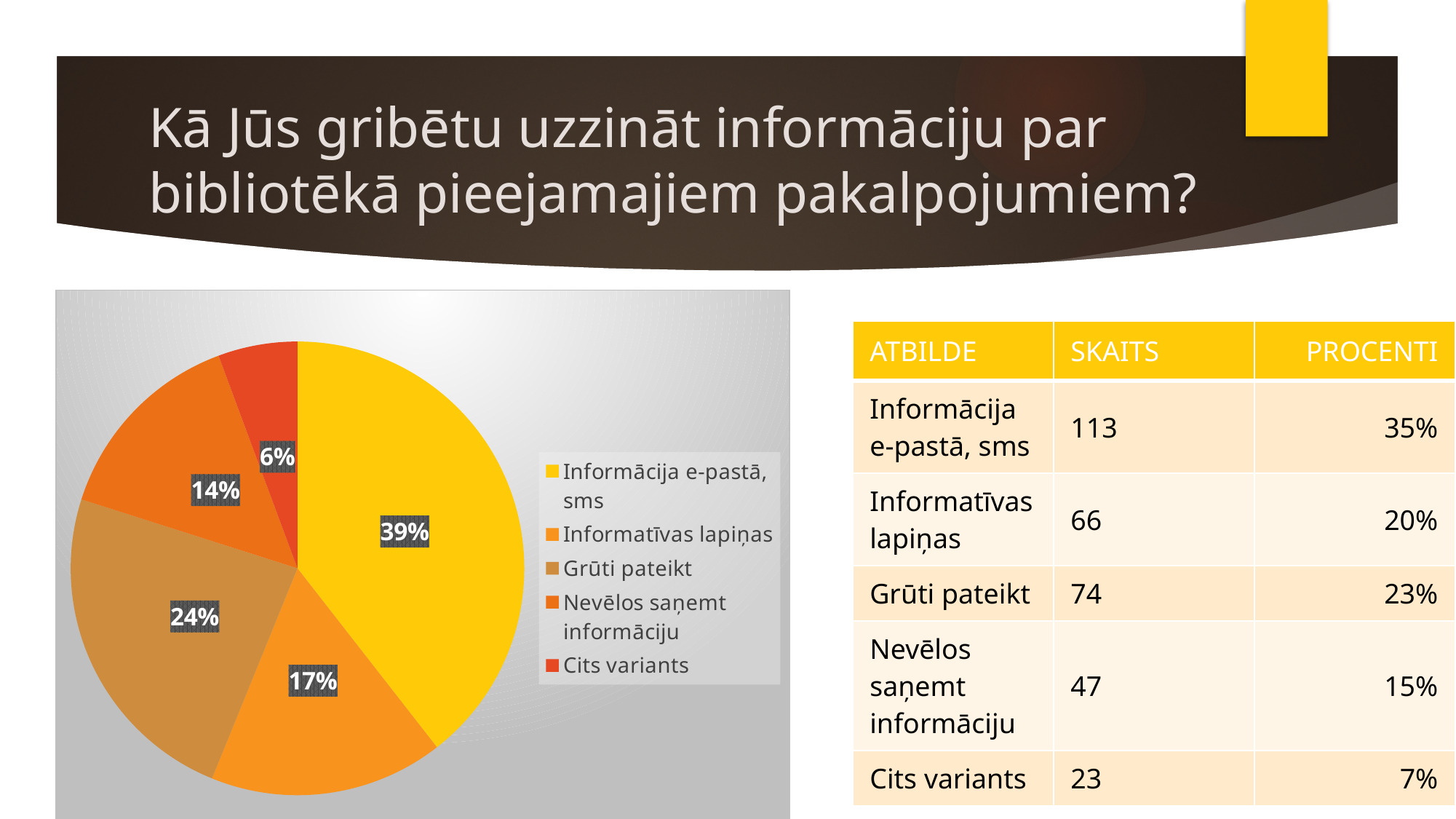
In the pie chart, what percentage is shown for "Informācija e-pastā, sms"? 39% In the pie chart, which is larger: "Informatīvas lapiņas" or "Nevēlos saņemt informāciju"? Informatīvas lapiņas In the pie chart, what percentage is shown for "Informatīvas lapiņas"? 17% In the pie chart, what is the difference in percentage points between "Informācija e-pastā, sms" and "Grūti pateikt"? 15 How many slices does the pie chart have? 5 In the pie chart, what percentage is shown for "Nevēlos saņemt informāciju"? 14% In the pie chart, what percentage is shown for "Grūti pateikt"? 24% How many entries does the pie chart's legend list? 5 Which slice of the pie chart is the smallest? Cits variants In the pie chart, what percentage is shown for "Cits variants"? 6% What kind of chart is shown on the slide? pie chart Which slice of the pie chart is the largest? Informācija e-pastā, sms